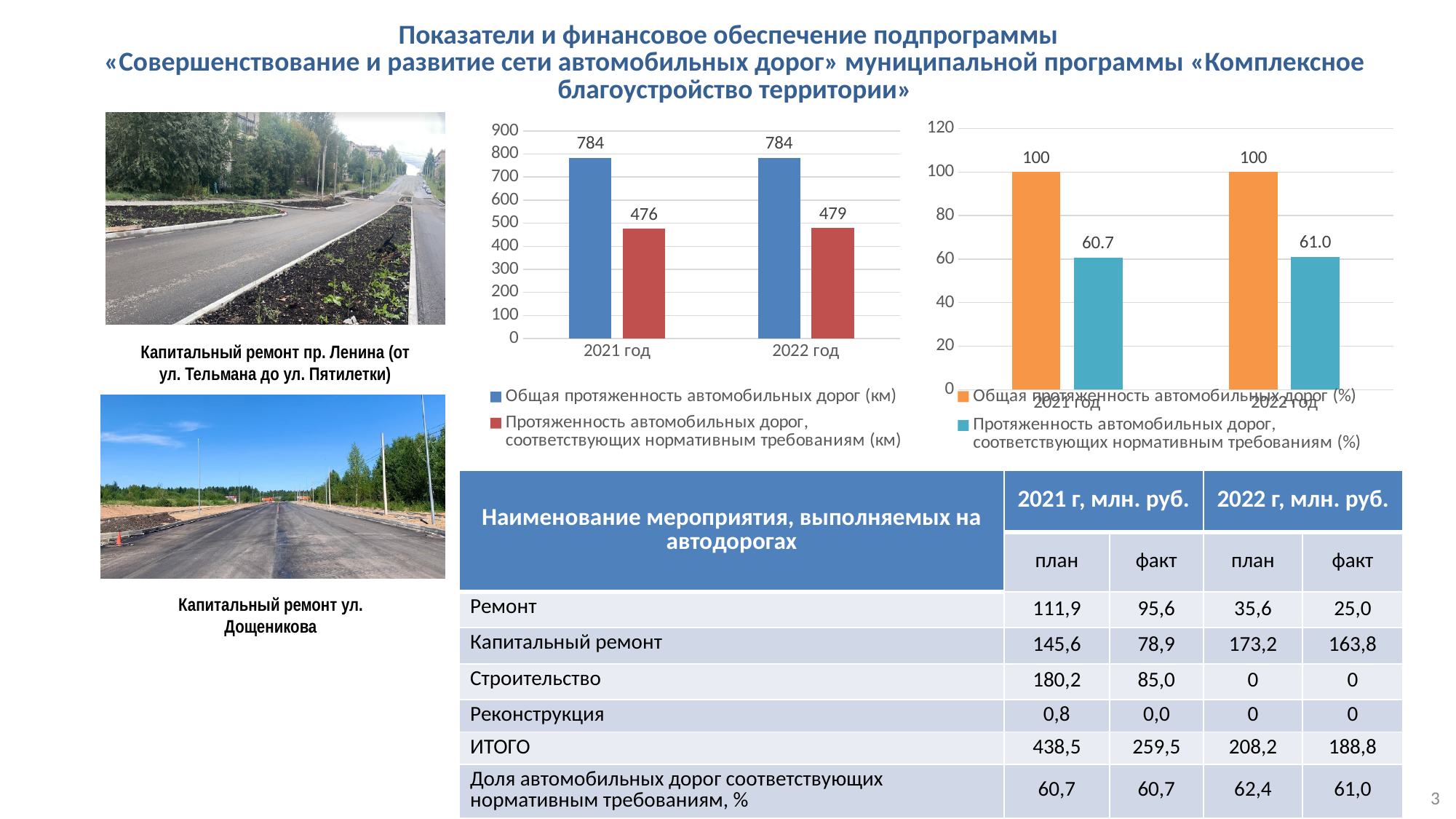
In the left chart (km), what is the length of roads meeting regulatory requirements in 2022 год? 479 In the right chart (%), how many categories are shown on the x axis? 2 In the right chart (%), what is the share of roads meeting regulatory requirements in 2021 год? 60.7 In the right chart (%), what is the share of roads meeting regulatory requirements in 2022 год? 61.0 In the left chart (km), what is the difference between the total road length and the length meeting regulatory requirements in 2021 год? 308 In the right chart (%), which is larger: the total road length value or the value for roads meeting regulatory requirements in 2022 год? Total road length (100) In the left chart (km), what colour are the bars for roads meeting regulatory requirements? Red In the left chart (km), does the length of roads meeting regulatory requirements rise or fall from 2021 год to 2022 год? Rise In the left chart (km), what kind of chart is shown? Bar chart In the right chart (%), what colour are the bars for the total road length series? Orange In the left chart (km), how many series does the legend list? 2 In the left chart (km), what is the total length of roads (Общая протяженность автомобильных дорог) in 2021 год? 784